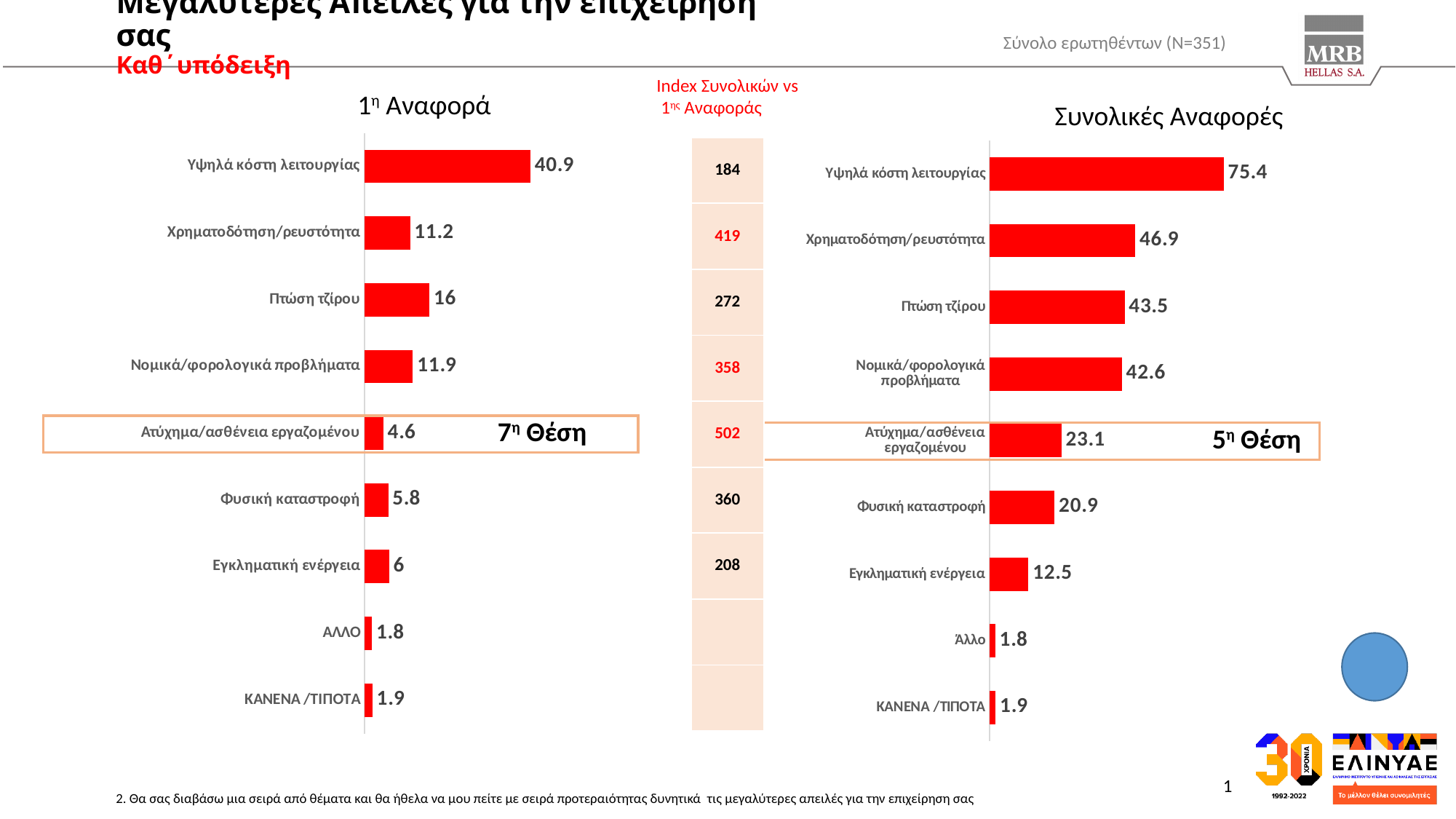
How many categories are shown in the 'Συνολικές Αναφορές' chart? 9 In the 'Συνολικές Αναφορές' chart, what is the value for Εγκληματική ενέργεια? 12.5 In the 'Συνολικές Αναφορές' chart, which category has the highest value? Υψηλά κόστη λειτουργίας In the 'Συνολικές Αναφορές' chart, what is the value for Ατύχημα/ασθένεια εργαζομένου? 23.1 In the 'Συνολικές Αναφορές' chart, what is the difference between Υψηλά κόστη λειτουργίας and Χρηματοδότηση/ρευστότητα? 28.5 In the '1η Αναφορά' chart, what is the value for Πτώση τζίρου? 16 In the 'Συνολικές Αναφορές' chart, which is larger: Πτώση τζίρου or Φυσική καταστροφή? Πτώση τζίρου In the '1η Αναφορά' chart, what is the difference between Πτώση τζίρου and Νομικά/φορολογικά προβλήματα? 4.1 In the '1η Αναφορά' chart, what is the value for Υψηλά κόστη λειτουργίας? 40.9 What kind of chart is the '1η Αναφορά' chart? Bar chart In the '1η Αναφορά' chart, which is larger: Φυσική καταστροφή or Εγκληματική ενέργεια? Εγκληματική ενέργεια In the '1η Αναφορά' chart, which category has the lowest value? ΑΛΛΟ